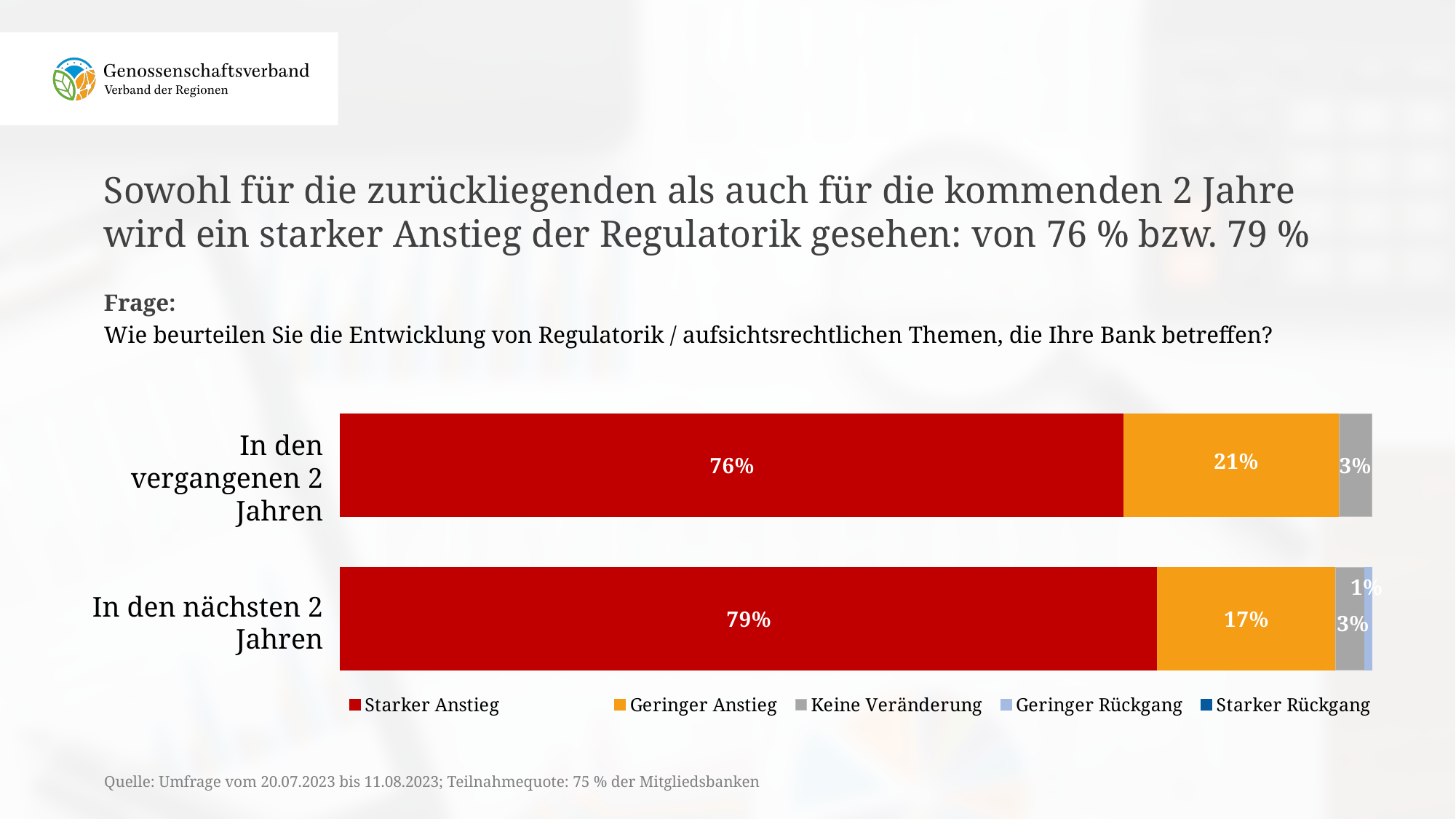
What is the value for "Keine Veränderung" in the "In den nächsten 2 Jahren" bar? 3% What share of respondents chose "Starker Anstieg" for "In den nächsten 2 Jahren"? 79% What is the difference between the "Geringer Anstieg" values for "In den vergangenen 2 Jahren" and "In den nächsten 2 Jahren"? 4% What share of respondents chose "Starker Anstieg" for "In den vergangenen 2 Jahren"? 76% What kind of chart is shown on the slide? Stacked bar chart What is the value for "Geringer Anstieg" in the "In den vergangenen 2 Jahren" bar? 21% Which category has the higher value for "Starker Anstieg": "In den vergangenen 2 Jahren" or "In den nächsten 2 Jahren"? In den nächsten 2 Jahren What is the value for "Geringer Anstieg" in the "In den nächsten 2 Jahren" bar? 17% How many categories (bars) are shown in the chart? 2 What is the value for "Geringer Rückgang" in the "In den nächsten 2 Jahren" bar? 1% What is the difference between the "Starker Anstieg" values for "In den nächsten 2 Jahren" and "In den vergangenen 2 Jahren"? 3% How many series does the legend list? 5